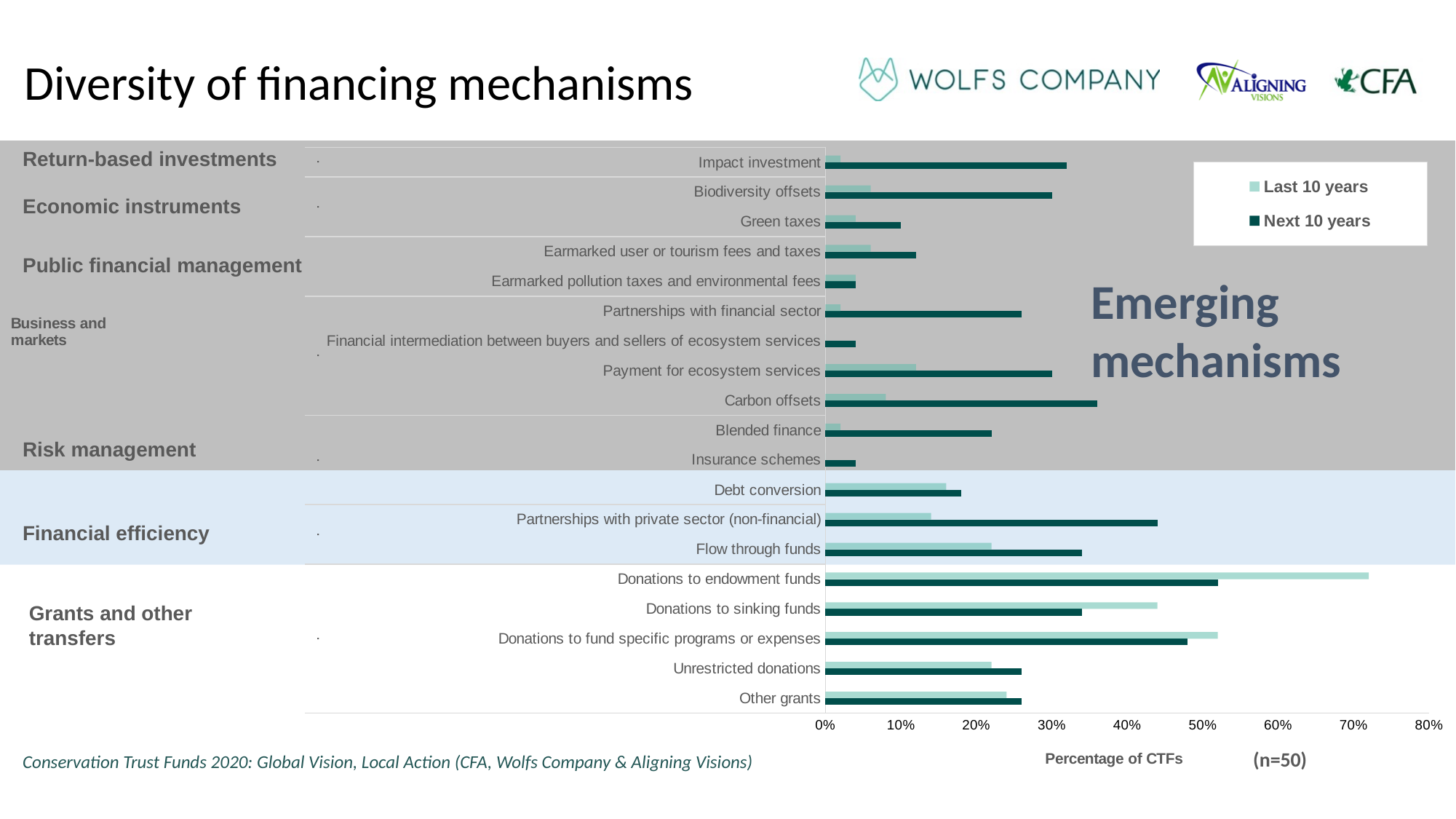
What are the two series named in the legend? Last 10 years and Next 10 years For Impact investment, which is larger: the Last 10 years value or the Next 10 years value? Next 10 years How many financing mechanisms (categories) are plotted in the chart? 19 How many series does the legend list? 2 Is the Next 10 years value for Carbon offsets greater or less than 30%? greater Is the Last 10 years value for Green taxes greater or less than 10%? less What kind of chart is shown on the slide? bar chart For Donations to endowment funds, which is larger: the Last 10 years value or the Next 10 years value? Last 10 years Is the Next 10 years value for Partnerships with private sector (non-financial) greater or less than 40%? greater Which financing mechanism has the highest value for Last 10 years? Donations to endowment funds What is the title of the horizontal axis? Percentage of CTFs